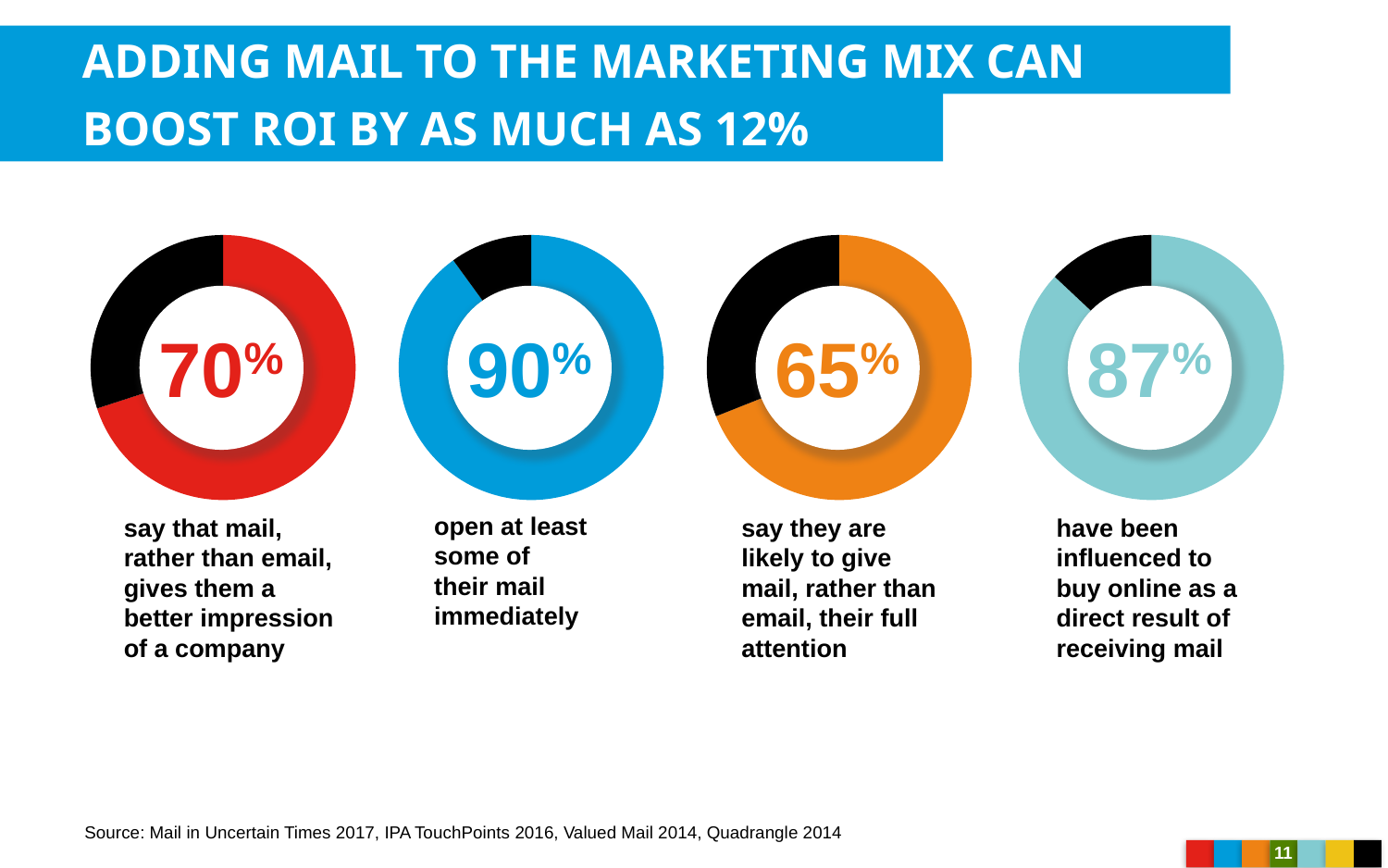
What is the difference between the rightmost donut chart's value (87%) and the leftmost donut chart's value (70%)? 17 percentage points What kind of chart is used to display the four percentages on the slide? donut chart What colour is the filled portion of the donut chart showing 65%? orange What percentage is shown in the leftmost donut chart (say that mail, rather than email, gives them a better impression of a company)? 70% What percentage is shown in the second donut chart from the left (open at least some of their mail immediately)? 90% How many donut charts are shown on the slide? 4 Which of the four donut charts shows the highest percentage? open at least some of their mail immediately (90%) Which is larger: the percentage in the leftmost donut chart or the percentage in the rightmost donut chart? the rightmost donut chart (87%) Which of the four donut charts shows the lowest percentage? say they are likely to give mail, rather than email, their full attention (65%) What percentage is shown in the rightmost donut chart (have been influenced to buy online as a direct result of receiving mail)? 87% What percentage is shown in the third donut chart from the left (say they are likely to give mail, rather than email, their full attention)? 65% What is the difference between the percentage in the second donut chart (90%) and the percentage in the third donut chart (65%)? 25 percentage points